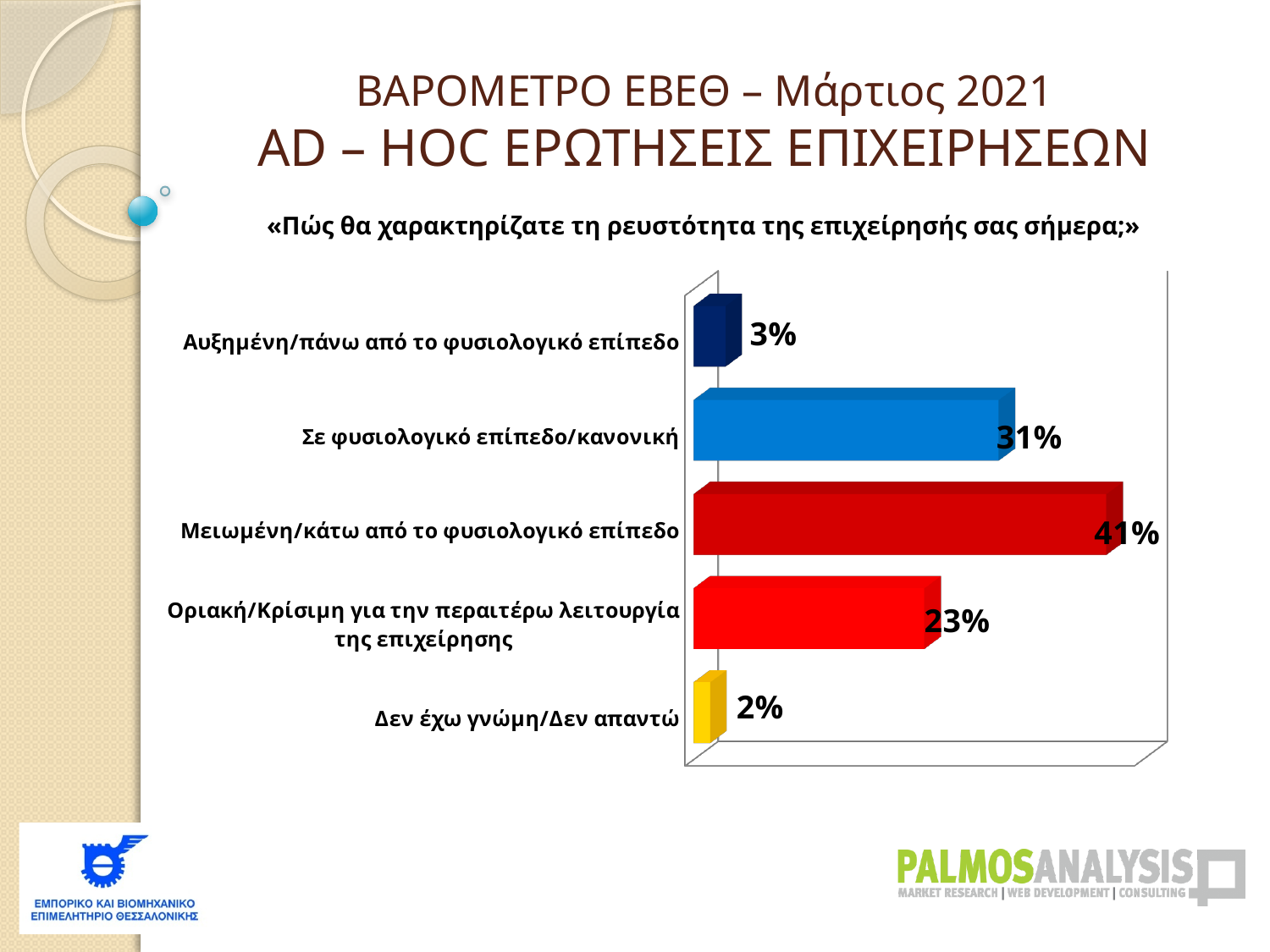
What is the difference between the values for "Οριακή/Κρίσιμη για την περαιτέρω λειτουργία της επιχείρησης" and "Αυξημένη/πάνω από το φυσιολογικό επίπεδο"? 20% Which is larger: the value for "Σε φυσιολογικό επίπεδο/κανονική" or the value for "Οριακή/Κρίσιμη για την περαιτέρω λειτουργία της επιχείρησης"? Σε φυσιολογικό επίπεδο/κανονική How many categories are shown in the chart? 5 What is the value for "Μειωμένη/κάτω από το φυσιολογικό επίπεδο"? 41% Which category has the highest value? Μειωμένη/κάτω από το φυσιολογικό επίπεδο Which category has the lowest value? Δεν έχω γνώμη/Δεν απαντώ What colour is the bar for "Δεν έχω γνώμη/Δεν απαντώ"? Yellow What is the value for "Αυξημένη/πάνω από το φυσιολογικό επίπεδο"? 3% What is the value for "Σε φυσιολογικό επίπεδο/κανονική"? 31% What is the value for "Δεν έχω γνώμη/Δεν απαντώ"? 2% What is the difference between the values for "Μειωμένη/κάτω από το φυσιολογικό επίπεδο" and "Σε φυσιολογικό επίπεδο/κανονική"? 10% What kind of chart is shown on the slide? Bar chart